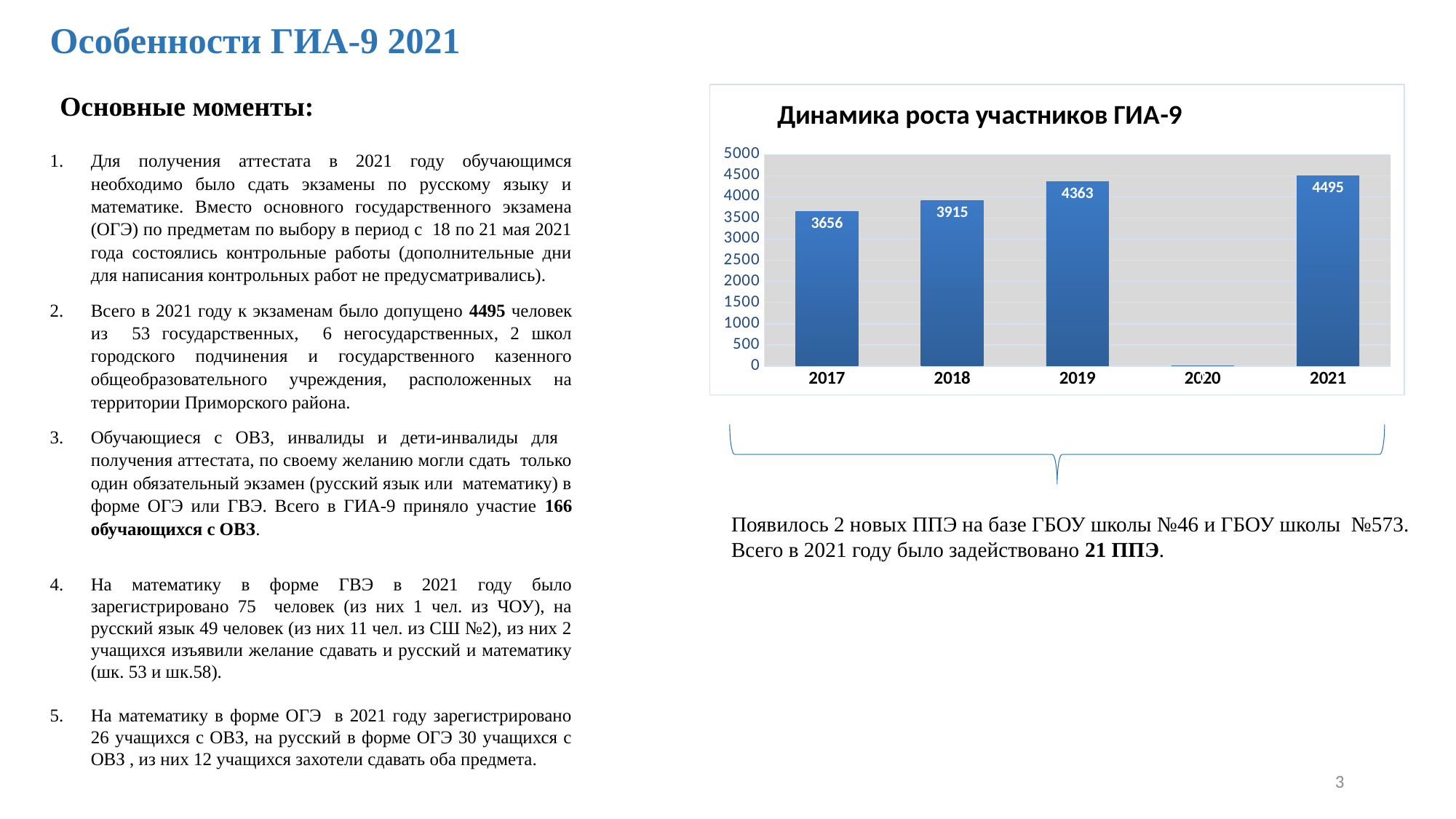
What is the difference between the values for 2018 and 2017 in the chart 'Динамика роста участников ГИА-9'? 259 Is the value for 2017 in the chart 'Динамика роста участников ГИА-9' greater or less than 4000? less What is the difference between the values for 2021 and 2019 in the chart 'Динамика роста участников ГИА-9'? 132 In the chart 'Динамика роста участников ГИА-9', which is larger: the value for 2018 or the value for 2019? 2019 Which year has the lowest value in the chart 'Динамика роста участников ГИА-9'? 2020 What is the value for 2017 in the chart 'Динамика роста участников ГИА-9'? 3656 What is the value for 2019 in the chart 'Динамика роста участников ГИА-9'? 4363 What is the value for 2021 in the chart 'Динамика роста участников ГИА-9'? 4495 What is the value for 2018 in the chart 'Динамика роста участников ГИА-9'? 3915 What kind of chart is 'Динамика роста участников ГИА-9'? bar chart Which year has the highest value in the chart 'Динамика роста участников ГИА-9'? 2021 How many years are shown on the x axis of the chart 'Динамика роста участников ГИА-9'? 5